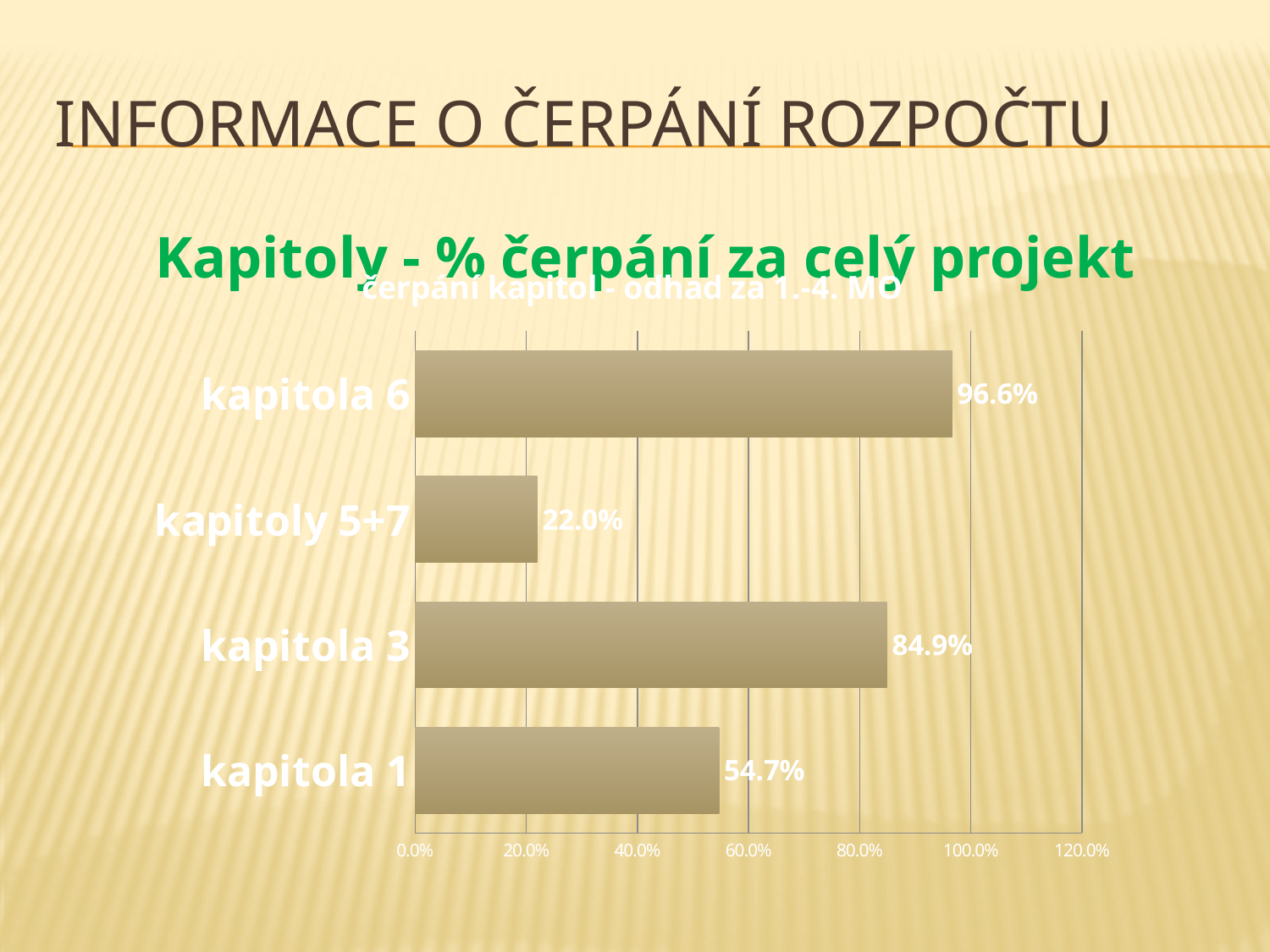
Is the value for kapitola 1 greater or less than 60.0%? less How many categories are shown in the chart? 4 Which category has the highest value? kapitola 6 What is the value for kapitola 6? 96.6% Which category has the lowest value? kapitoly 5+7 What is the value for kapitoly 5+7? 22.0% What is the value for kapitola 3? 84.9% What is the value for kapitola 1? 54.7% Which is larger, the value for kapitola 3 or the value for kapitola 1? kapitola 3 What kind of chart is shown on the slide? bar chart What is the difference between the values for kapitola 1 and kapitoly 5+7? 32.7% What is the difference between the values for kapitola 6 and kapitola 3? 11.7%